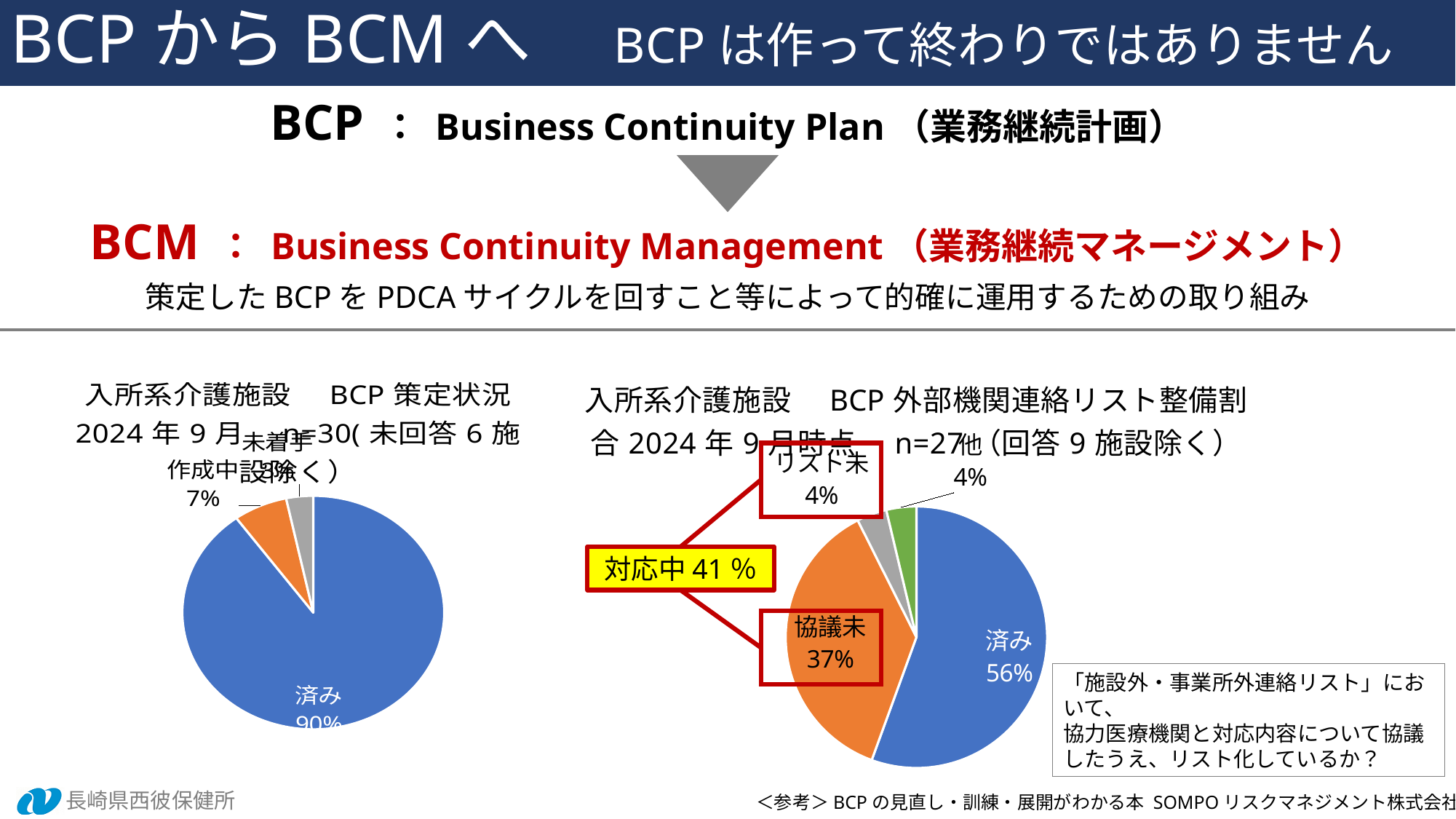
In the right chart (BCP外部機関連絡リスト整備割合), what share is labelled 済み? 56% In the left chart (BCP策定状況), which category has the largest slice? 済み In the right chart (BCP外部機関連絡リスト整備割合), what value does the yellow 対応中 callout give? 41% What kind of chart is the left chart (入所系介護施設 BCP策定状況)? pie chart In the right chart (BCP外部機関連絡リスト整備割合), what share is labelled 他? 4% In the left chart (BCP策定状況), what share is labelled 済み? 90% In the left chart (BCP策定状況), what share is labelled 作成中? 7% In the right chart (BCP外部機関連絡リスト整備割合), which category has the largest slice? 済み In the right chart (BCP外部機関連絡リスト整備割合), how many percentage points larger is 済み than 協議未? 19% Which 済み share is larger: the left chart (BCP策定状況) or the right chart (BCP外部機関連絡リスト整備割合)? the left chart (BCP策定状況) In the right chart (BCP外部機関連絡リスト整備割合), what share is labelled 協議未? 37% In the right chart (BCP外部機関連絡リスト整備割合), what share is labelled リスト未? 4%